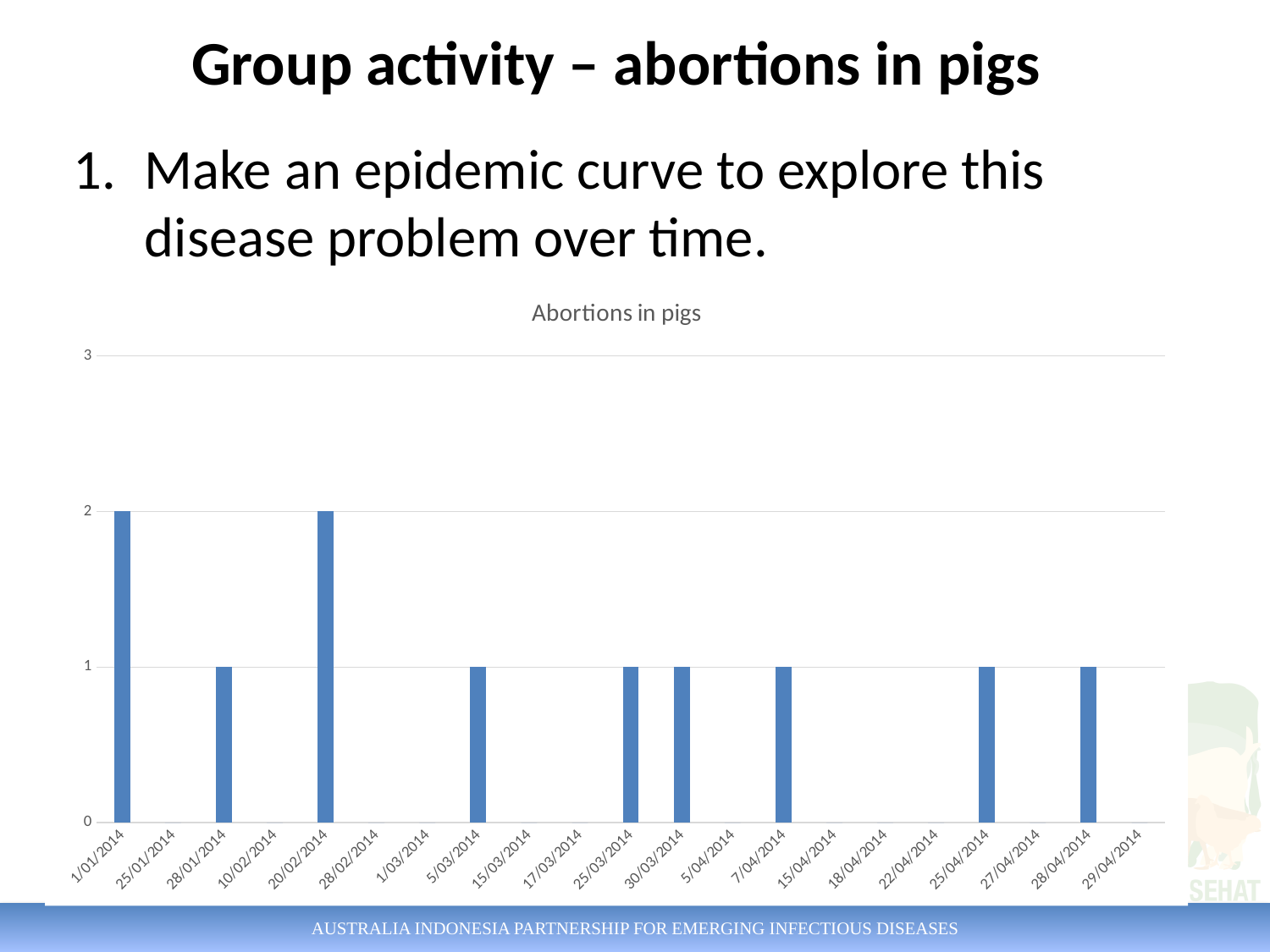
What is the value for 1/01/2014? 2 How many dates are labelled on the x axis? 21 Is the value for 1/01/2014 greater or less than 1? greater What kind of chart is shown on the slide? bar chart What is the value for 7/04/2014? 1 What is the title of the chart? Abortions in pigs Which dates have the highest value on the chart? 1/01/2014 and 20/02/2014 What is the value for 20/02/2014? 2 Which has the larger value, 20/02/2014 or 5/03/2014? 20/02/2014 What is the value for 28/01/2014? 1 What is the highest value shown on the chart? 2 What is the difference between the values for 1/01/2014 and 28/01/2014? 1